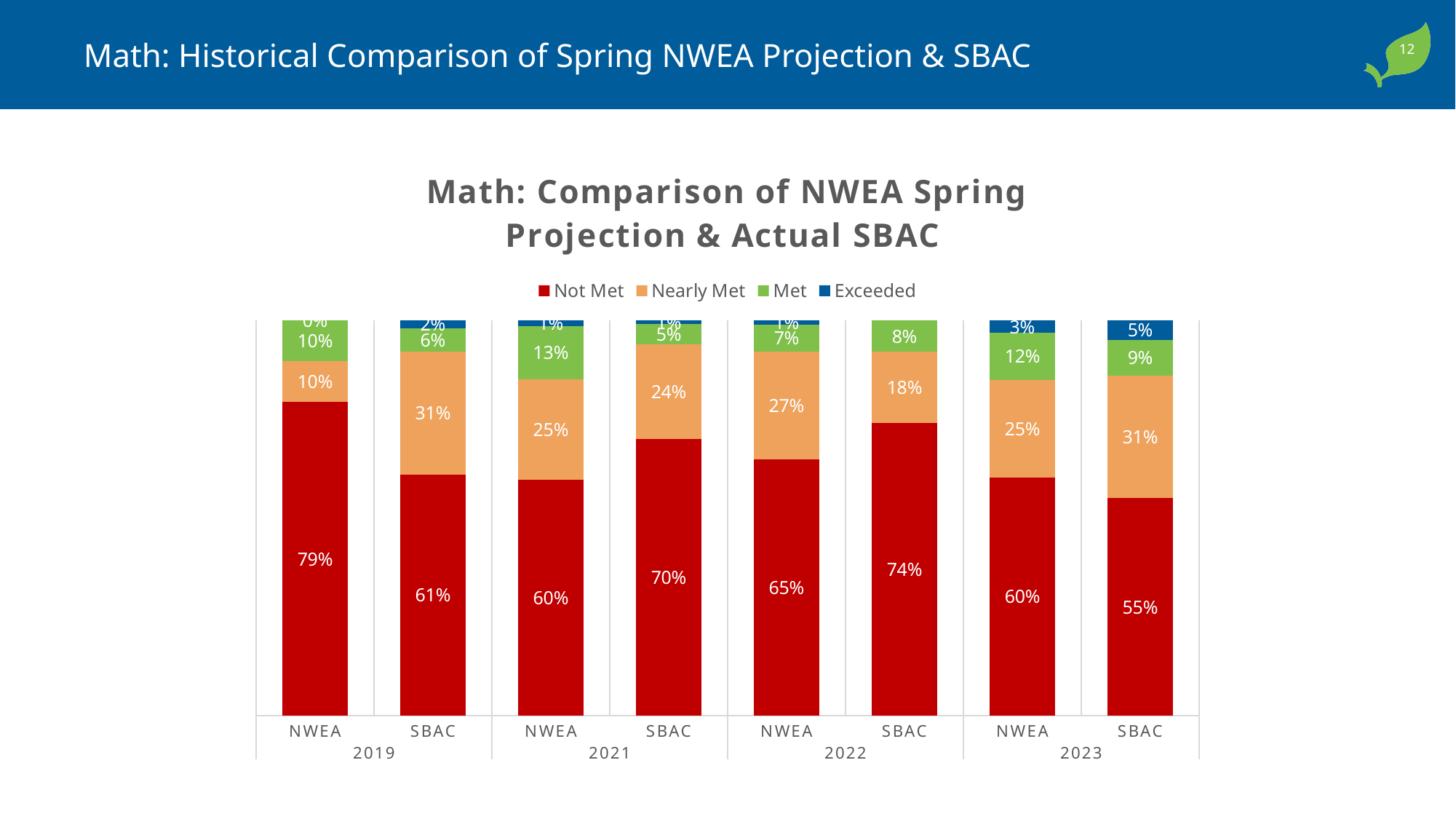
What is the difference between the Not Met percentage for SBAC in 2021 and NWEA in 2021? 10% Which bar has the highest Not Met percentage? NWEA 2019 How many bars are plotted in the chart? 8 Which bar has the lowest Not Met percentage? SBAC 2023 What is the Not Met percentage for NWEA in 2019? 79% What is the Met percentage for NWEA in 2021? 13% What is the Exceeded percentage for SBAC in 2023? 5% Which has a larger Nearly Met percentage in 2022, NWEA or SBAC? NWEA What kind of chart is shown on the slide? stacked bar chart What is the Nearly Met percentage for SBAC in 2023? 31% Which series is shown in red in the legend? Not Met How many series does the legend list? 4